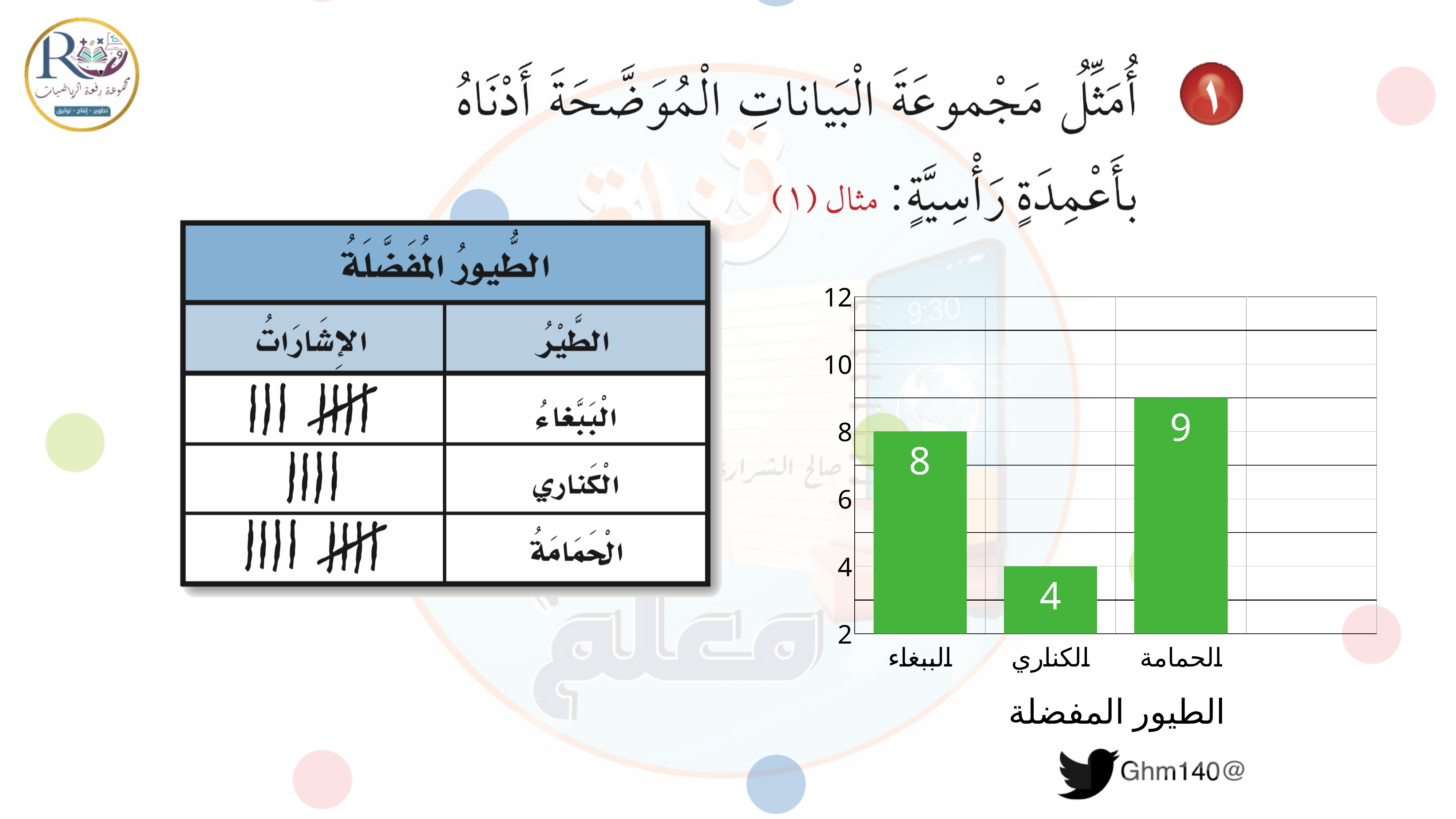
Which is larger, the value for الببغاء or the value for الكناري? الببغاء What is the difference between the values for الببغاء and الكناري? 4 What is the title of the chart? الطيور المفضلة Is the value for الحمامة greater or less than 6? greater How many categories are shown in the chart? 3 Which category has the lowest value in the chart? الكناري What is the value for الحمامة in the chart? 9 What is the value for الببغاء in the chart? 8 What kind of chart is shown on the slide? bar chart What is the value for الكناري in the chart? 4 Which category has the highest value in the chart? الحمامة What is the difference between the values for الحمامة and الكناري? 5